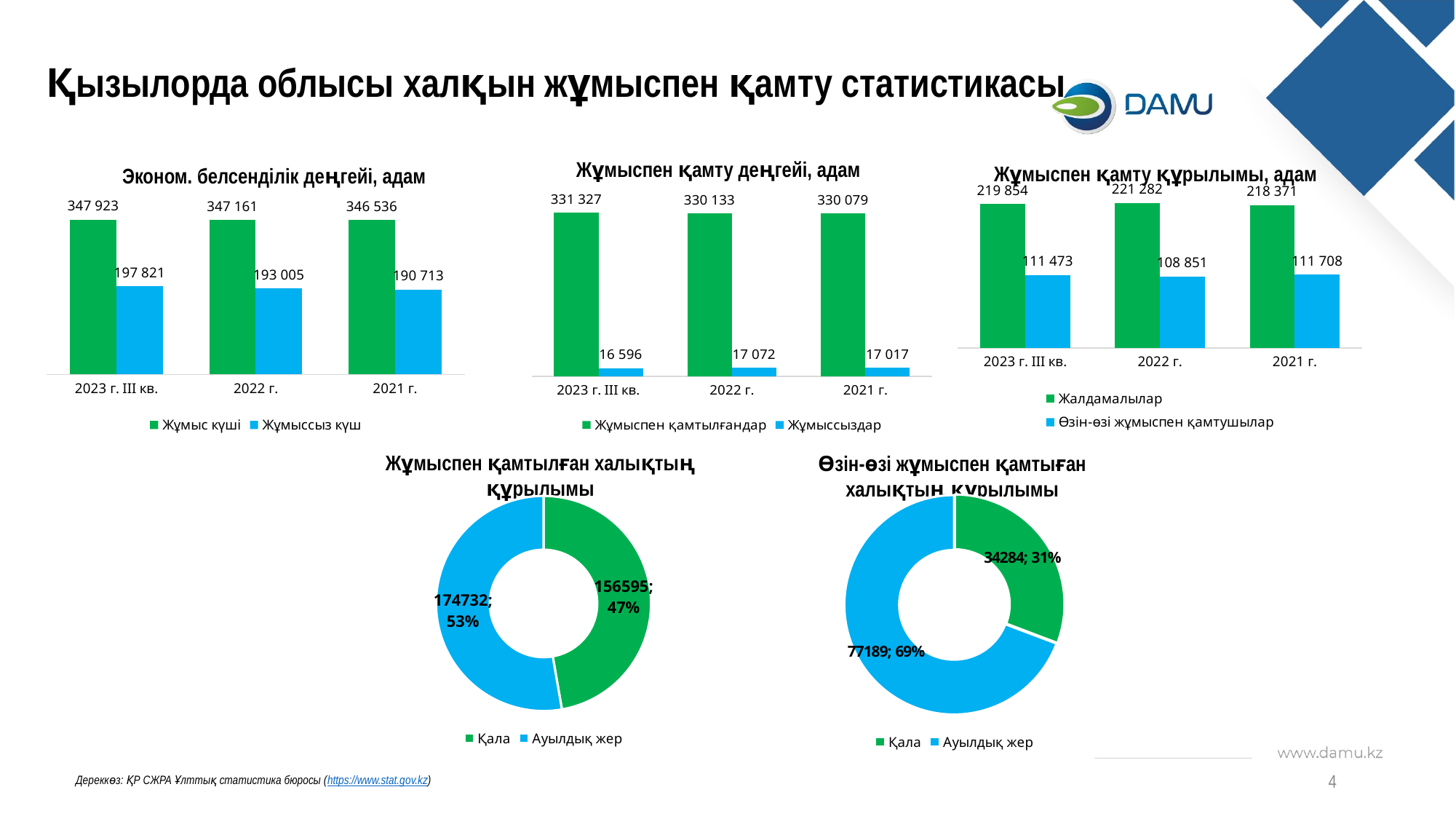
In the chart titled "Эконом. белсенділік деңгейі, адам", what is the value of Жұмыс күші for 2023 г. III кв.? 347 923 What kind of chart is the one titled "Өзін-өзі жұмыспен қамтыған халықтың құрылымы"? Doughnut chart In the chart titled "Жұмыспен қамту құрылымы, адам", which period has the lowest value for Өзін-өзі жұмыспен қамтушылар? 2022 г. In the chart titled "Жұмыспен қамту деңгейі, адам", what is the value of Жұмыссыздар for 2022 г.? 17 072 In the chart titled "Эконом. белсенділік деңгейі, адам", what is the value of Жұмыссыз күш for 2021 г.? 190 713 In the chart titled "Жұмыспен қамтылған халықтың құрылымы", what share does Ауылдық жер have? 53% In the chart titled "Жұмыспен қамту құрылымы, адам", what is the value of Жалдамалылар for 2022 г.? 221 282 In the chart titled "Жұмыспен қамту құрылымы, адам", how many series does the legend list? 2 In the chart titled "Жұмыспен қамту деңгейі, адам", what is the difference between Жұмыспен қамтылғандар and Жұмыссыздар for 2021 г.? 313 062 In the chart titled "Жұмыспен қамту деңгейі, адам", which period has the highest value for Жұмыспен қамтылғандар? 2023 г. III кв. In the chart titled "Жұмыспен қамтылған халықтың құрылымы", what is the value for Қала? 156595 In the chart titled "Өзін-өзі жұмыспен қамтыған халықтың құрылымы", which is larger, Қала or Ауылдық жер? Ауылдық жер